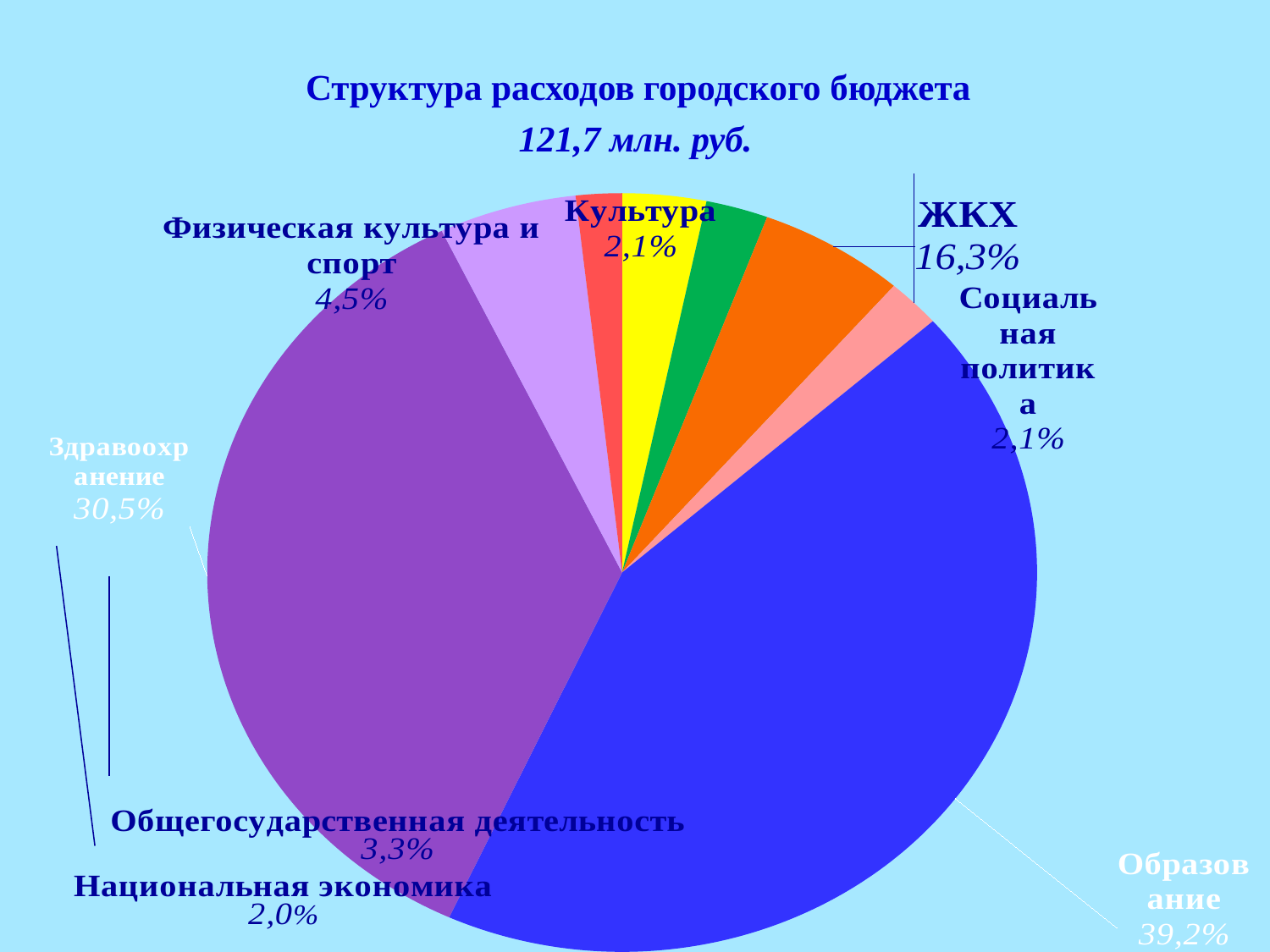
By how many percentage points does the share for Образование exceed the share for Здравоохранение? 8,7 Which category has the largest share of the budget? Образование What share of the budget goes to Общегосударственная деятельность? 3,3% What kind of chart is shown on the slide? Pie chart What share of the budget goes to Физическая культура и спорт? 4,5% What share of the budget goes to ЖКХ? 16,3% What share of the budget goes to Здравоохранение? 30,5% What is the title of the chart? Структура расходов городского бюджета Which is larger, the share for Здравоохранение or the share for ЖКХ? Здравоохранение How many slices does the pie chart have? 8 What total budget amount is shown under the chart title? 121,7 млн. руб. What share of the budget goes to Образование? 39,2%